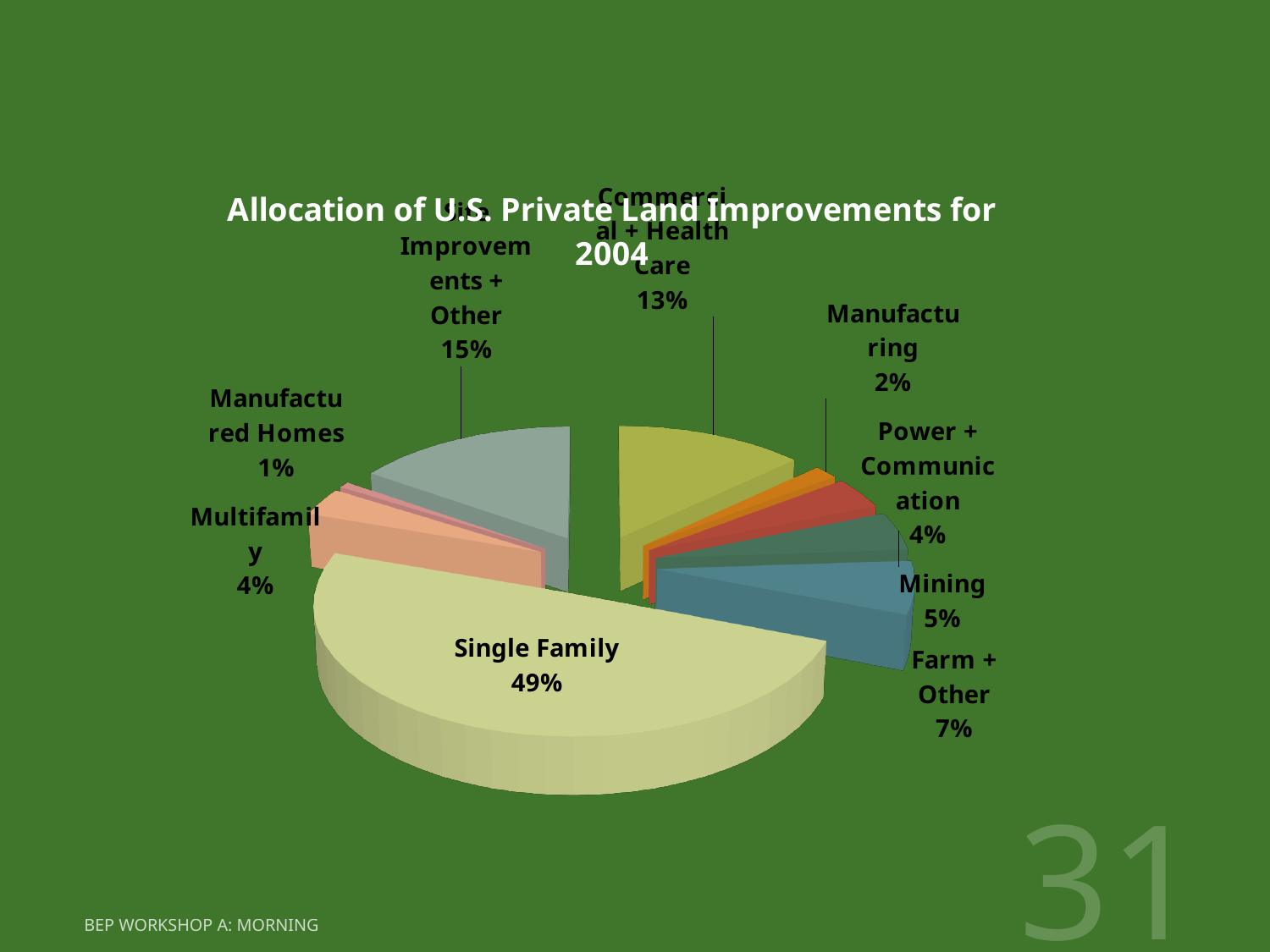
Which is larger, the share for Mining or the share for Multifamily? Mining Which category has the smallest slice of the pie? Manufactured Homes Which category has the largest slice of the pie? Single Family What share of U.S. private land improvements for 2004 went to Single Family? 49% What is the title of the chart? Allocation of U.S. Private Land Improvements for 2004 What percentage is shown for Commercial + Health Care? 13% What percentage is shown for Power + Communication? 4% What type of chart is shown on the slide? Pie chart What is the difference in percentage points between Farm + Other and Manufacturing? 5 How many slices does the pie chart have? 9 What percentage is shown for Farm + Other? 7% What percentage is shown for Mining? 5%